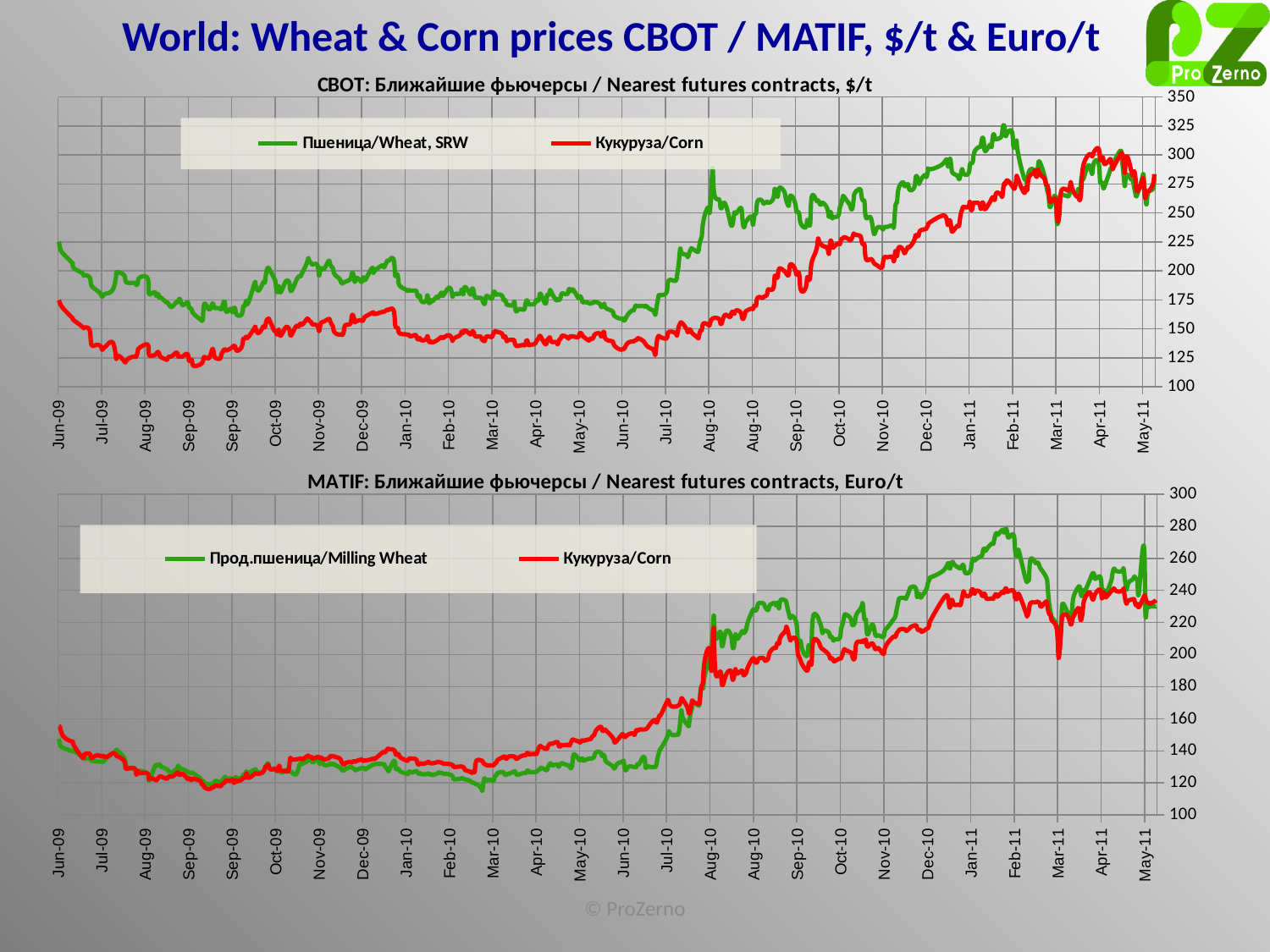
In the CBOT chart, is the value for Кукуруза/Corn in Sep-09 greater or less than 150? less In the CBOT chart, is the peak value for Пшеница/Wheat, SRW around Feb-11 greater or less than 300? greater In the CBOT chart, is the value for Пшеница/Wheat, SRW in Jun-09 greater or less than 200? greater In the CBOT chart, which series has the higher value in Jun-09, Пшеница/Wheat, SRW or Кукуруза/Corn? Пшеница/Wheat, SRW What kind of chart is the CBOT chart at the top of the slide? line chart In the CBOT chart, which colour is used for the Кукуруза/Corn series? red What is the title of the lower chart on the slide? MATIF: Ближайшие фьючерсы / Nearest futures contracts, Euro/t How many series does the legend of the MATIF chart list? 2 In the CBOT chart, does the Кукуруза/Corn series overall rise or fall from Jun-09 to May-11? rise In the MATIF chart, does the Прод.пшеница/Milling Wheat series overall rise or fall from Jul-10 to Feb-11? rise